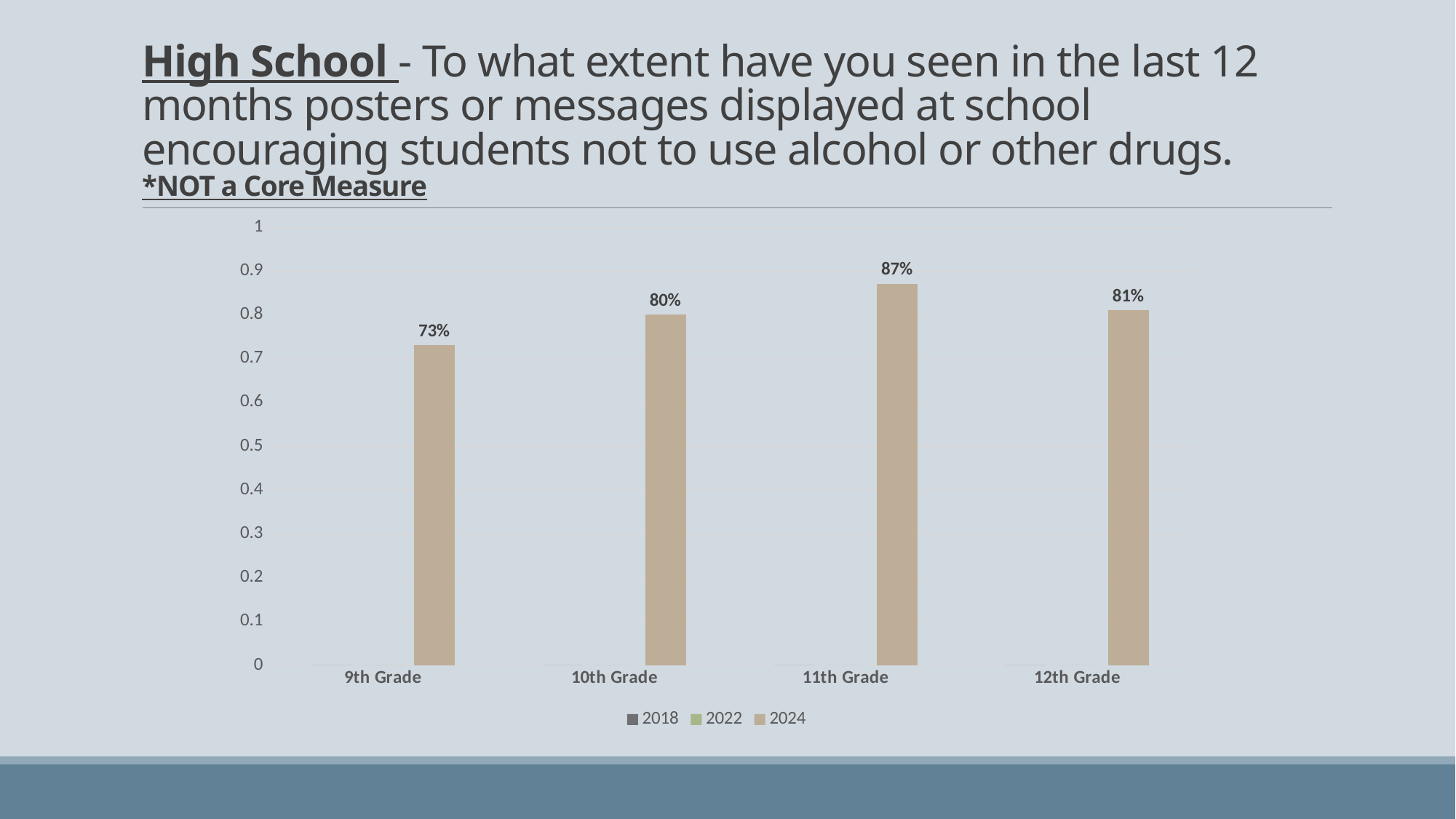
Which grade has the lowest 2024 value? 9th Grade What is the 2024 value for 11th Grade? 87% How many series does the legend list? 3 What is the 2024 value for 9th Grade? 73% Which grade has the highest 2024 value? 11th Grade How many grade categories are shown on the x axis? 4 What kind of chart is shown on the slide? bar chart What is the 2024 value for 12th Grade? 81% What is the difference between the 2024 values for 11th Grade and 9th Grade? 14% What is the 2024 value for 10th Grade? 80% Is the 2024 value for 9th Grade greater or less than 0.8? less Which has a larger 2024 value, 10th Grade or 12th Grade? 12th Grade